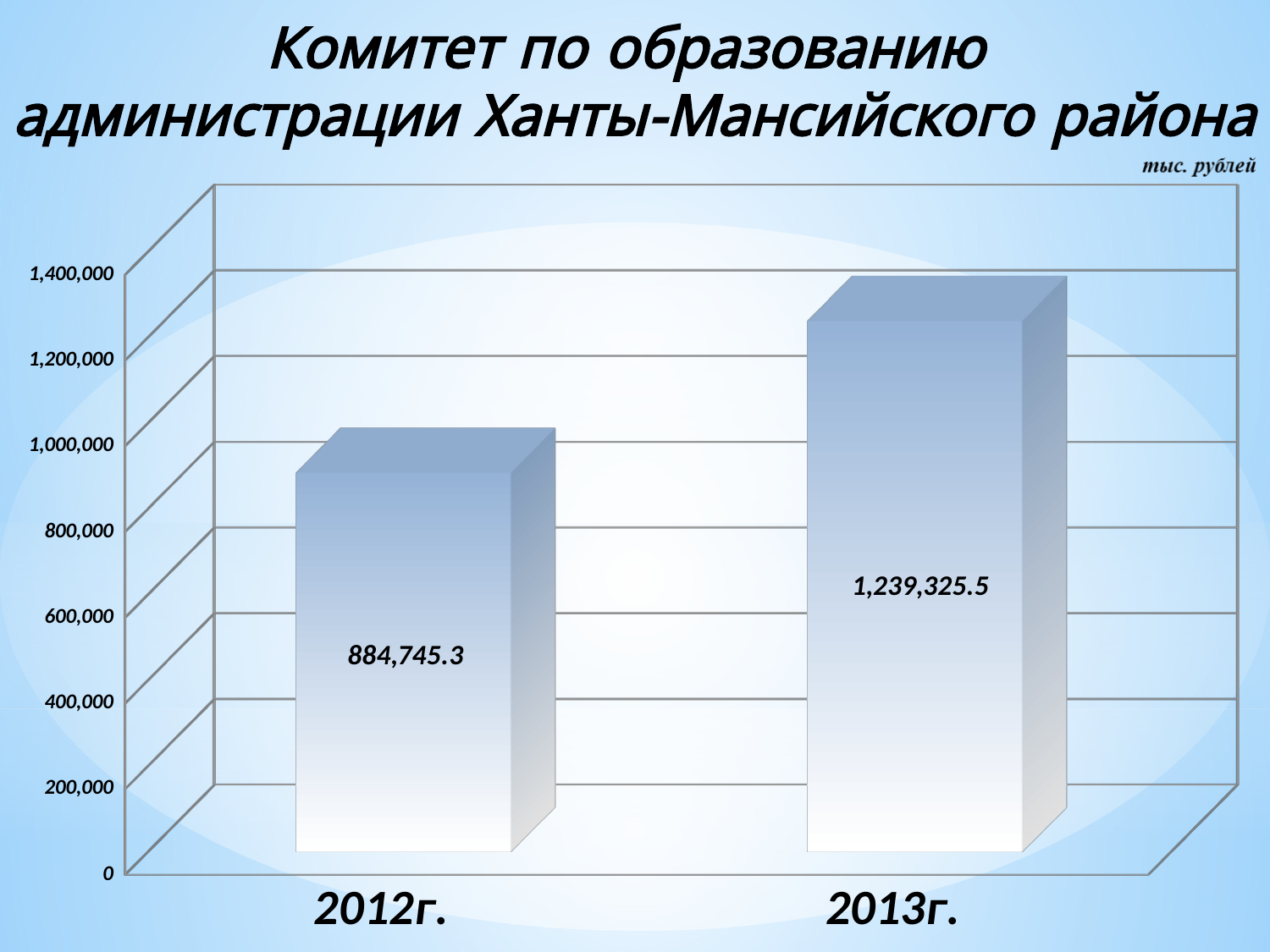
Is the value for 2012г. larger or smaller than the value for 2013г.? smaller What is the value shown for 2013г.? 1,239,325.5 Is the value for 2012г. greater or less than 1,000,000? less Do the values rise or fall from 2012г. to 2013г.? rise Which year has the lower value? 2012г. What is the difference between the values for 2013г. and 2012г.? 354,580.2 What kind of chart is shown on the slide? bar chart What is the value shown for 2012г.? 884,745.3 What unit is indicated above the chart? тыс. рублей Which year has the higher value? 2013г. Is the value for 2013г. greater or less than 1,200,000? greater How many bars are plotted on the chart? 2